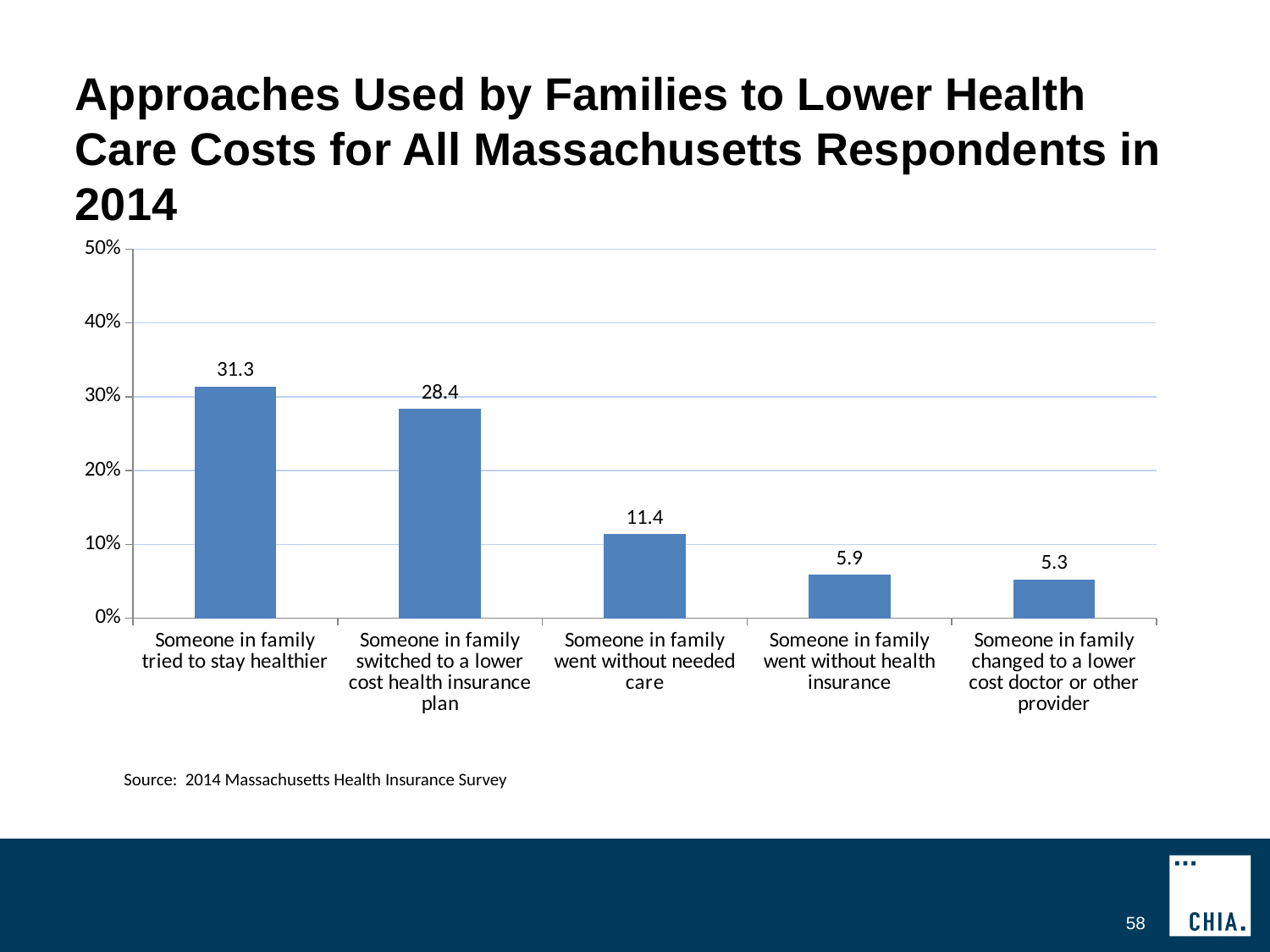
What is the value for 'Someone in family switched to a lower cost health insurance plan'? 28.4 What is the difference between the values for 'Someone in family tried to stay healthier' and 'Someone in family switched to a lower cost health insurance plan'? 2.9 Is the value for 'Someone in family went without health insurance' greater or less than 10%? less What is the value for 'Someone in family changed to a lower cost doctor or other provider'? 5.3 What is the source cited below the chart? 2014 Massachusetts Health Insurance Survey What kind of chart is shown on the slide? bar chart What is the value for 'Someone in family went without needed care'? 11.4 Which category has the highest value? Someone in family tried to stay healthier Which category has the lowest value? Someone in family changed to a lower cost doctor or other provider How many categories are shown in the chart? 5 What is the value for 'Someone in family tried to stay healthier'? 31.3 Which is larger: the value for 'Someone in family went without needed care' or 'Someone in family went without health insurance'? Someone in family went without needed care